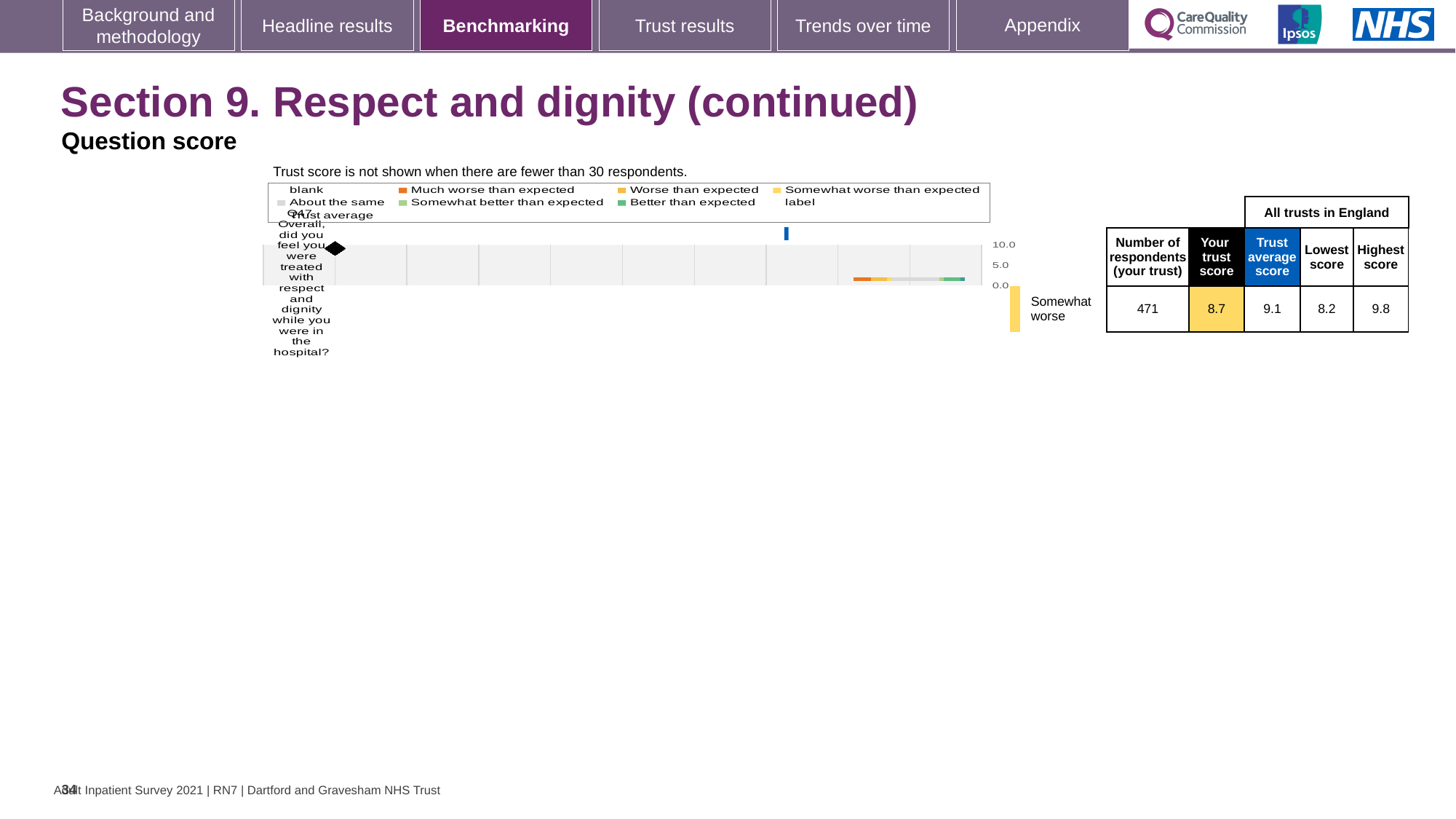
How many respondents from the trust answered Q47? 471 What is the difference between the trust average score and the trust's own score for Q47? 0.4 What is the trust score for Q47 (Overall, did you feel you were treated with respect and dignity while you were in the hospital?)? 8.7 Is the trust score for Q47 greater or less than 5.0? greater Which is larger for Q47: the trust's own score or the trust average score? Trust average score Which benchmarking category is the trust's Q47 score labelled as? Somewhat worse How many survey questions are plotted on the chart? 1 What is the highest score among all trusts in England for Q47? 9.8 What is the trust average score for Q47 across all trusts in England? 9.1 What is the difference between the highest and lowest scores across all trusts in England for Q47? 1.6 What kind of chart is used to show the Q47 benchmarking result? Bar chart What is the lowest score among all trusts in England for Q47? 8.2